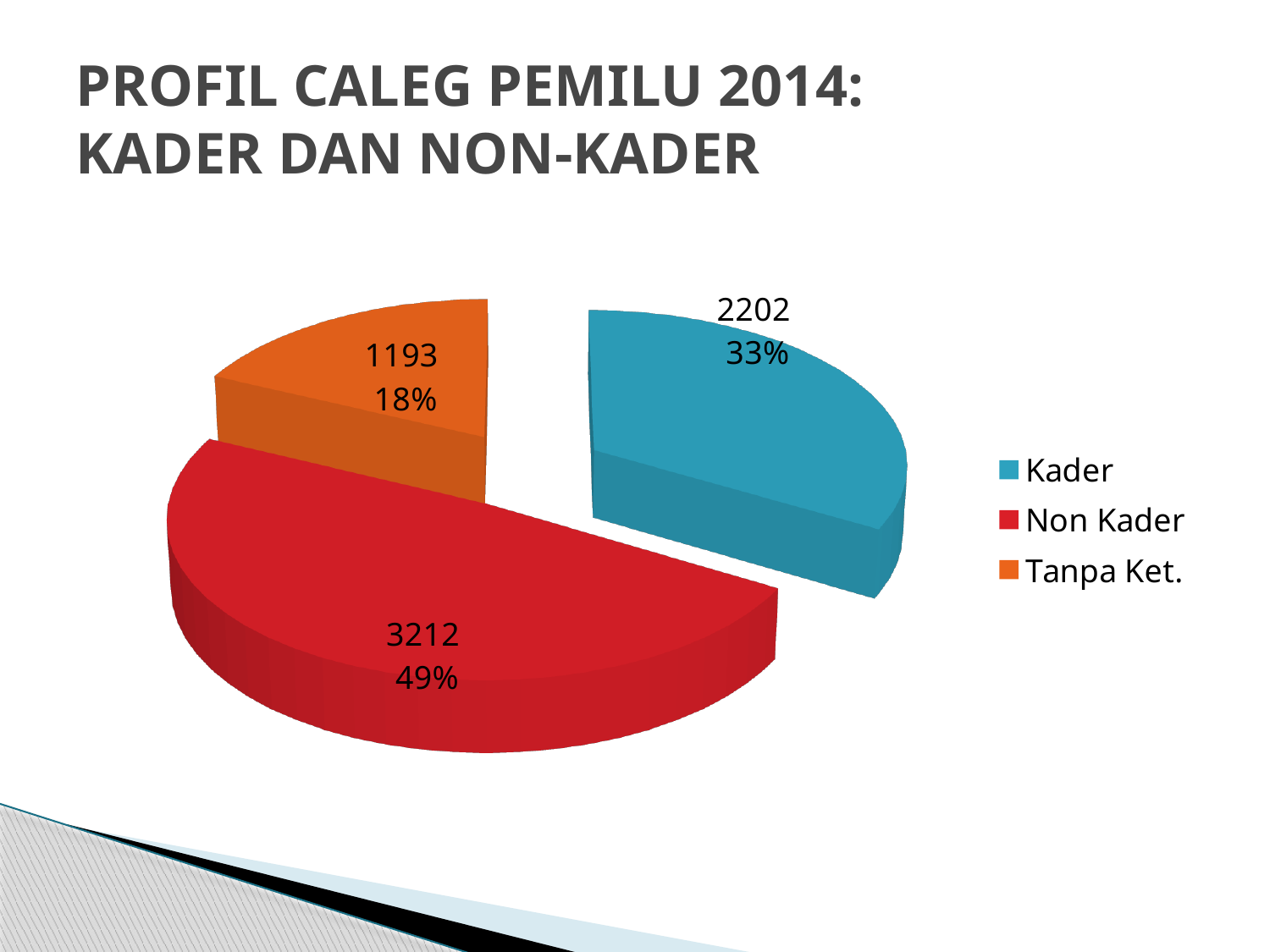
What is the difference between the values for Non Kader and Kader? 1010 What colour is the Tanpa Ket. slice? Orange What kind of chart is shown on the slide? Pie chart Which category has the smallest slice? Tanpa Ket. What share of the pie does Non Kader represent? 49% Which is larger, the value for Kader or the value for Tanpa Ket.? Kader What share of the pie does Kader represent? 33% What is the value for Non Kader? 3212 Which category has the largest slice? Non Kader How many slices does the pie chart have? 3 What is the value for Kader? 2202 What is the value for Tanpa Ket.? 1193